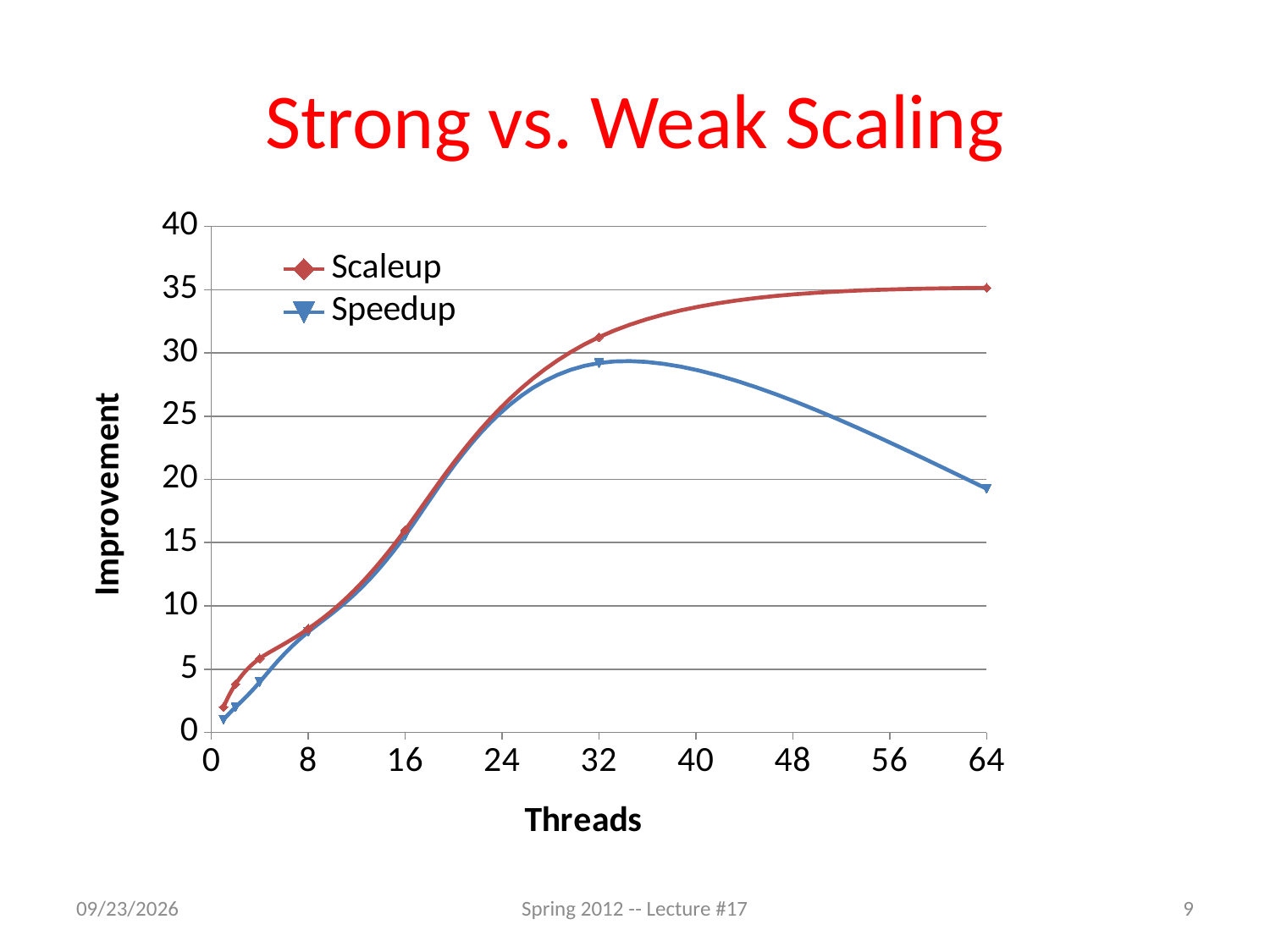
Is the Speedup value at 64 threads greater or less than 20? less What are the two series named in the legend? Scaleup and Speedup What is the title of the chart's x axis? Threads At 64 threads, which series has the larger value, Scaleup or Speedup? Scaleup What kind of chart is shown on the slide? Line chart How many series does the legend list? 2 Is the Speedup value at 32 threads greater or less than 30? less At which number of threads does the Speedup series reach its highest value? 32 Is the Scaleup value at 64 threads greater or less than 30? greater Does the Speedup series rise or fall between 32 and 64 threads? Fall How many data points are plotted for the Scaleup series? 7